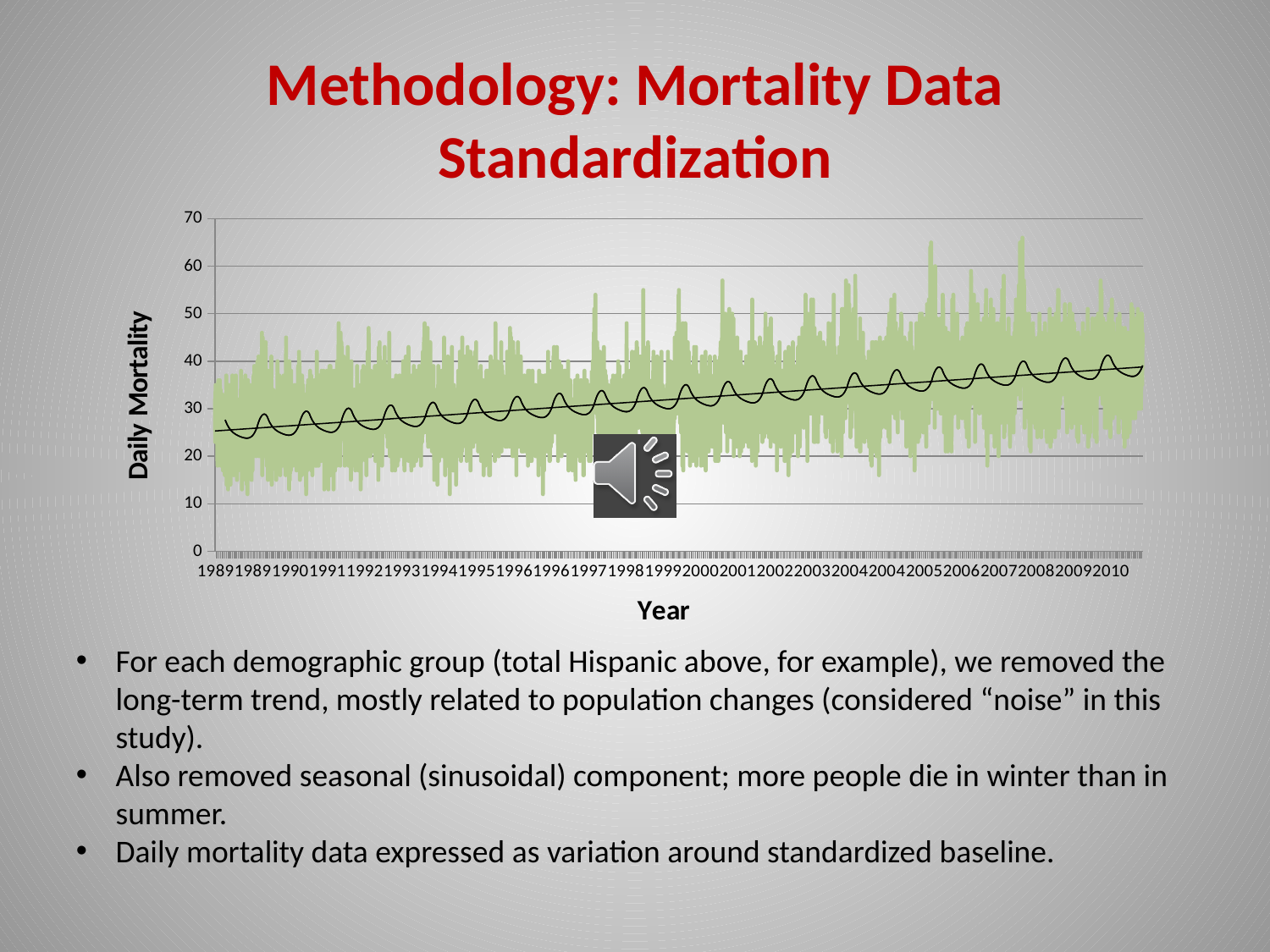
What kind of chart is shown on the slide? line chart Is the highest daily mortality value plotted on the chart greater or less than 60? greater Does the long-term trend line of daily mortality rise or fall from 1989 to 2010? rise Is the trend line value for daily mortality in 2010 greater or less than 30? greater What is the highest value shown on the vertical axis of the chart? 70 What is the label of the vertical axis of the chart? Daily Mortality What is the label of the horizontal axis of the chart? Year Is the trend line value for daily mortality in 1989 greater or less than 30? less Which year has the higher trend line value for daily mortality, 1989 or 2010? 2010